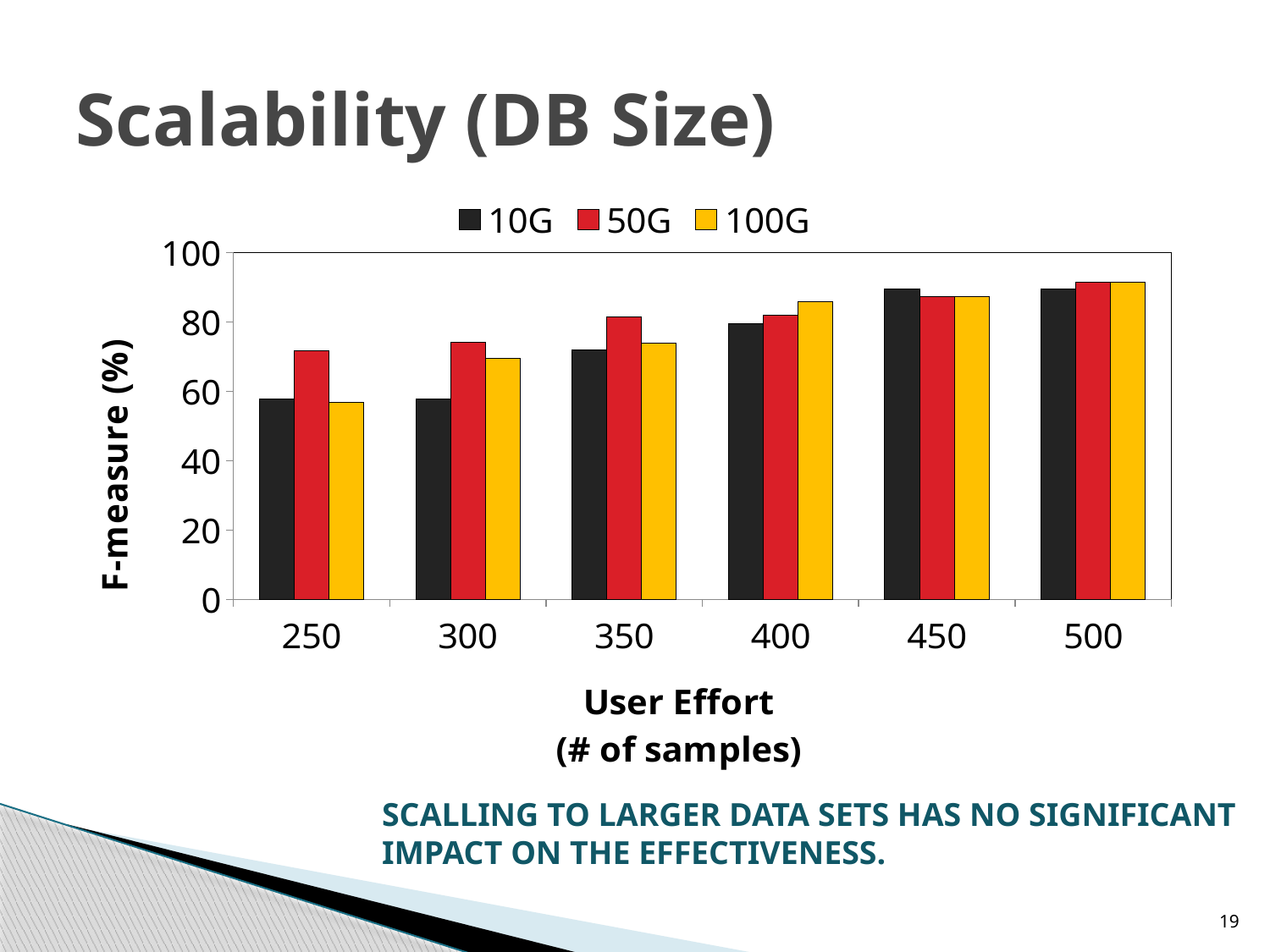
How many user effort categories are shown on the x axis? 6 At 250 samples, which series has the larger F-measure, 10G or 50G? 50G Is the F-measure for 10G at 250 samples greater or less than 80? less At 400 samples, which series has the larger F-measure, 10G or 100G? 100G How many series does the legend list? 3 What are the three series listed in the legend? 10G, 50G, 100G Is the F-measure for 10G at 450 samples greater or less than 80? greater Is the F-measure for 50G at 250 samples greater or less than 60? greater What is the label of the y axis? F-measure (%) What kind of chart is shown on the slide? bar chart Does the F-measure for 10G generally rise or fall as user effort increases from 250 to 500 samples? rise